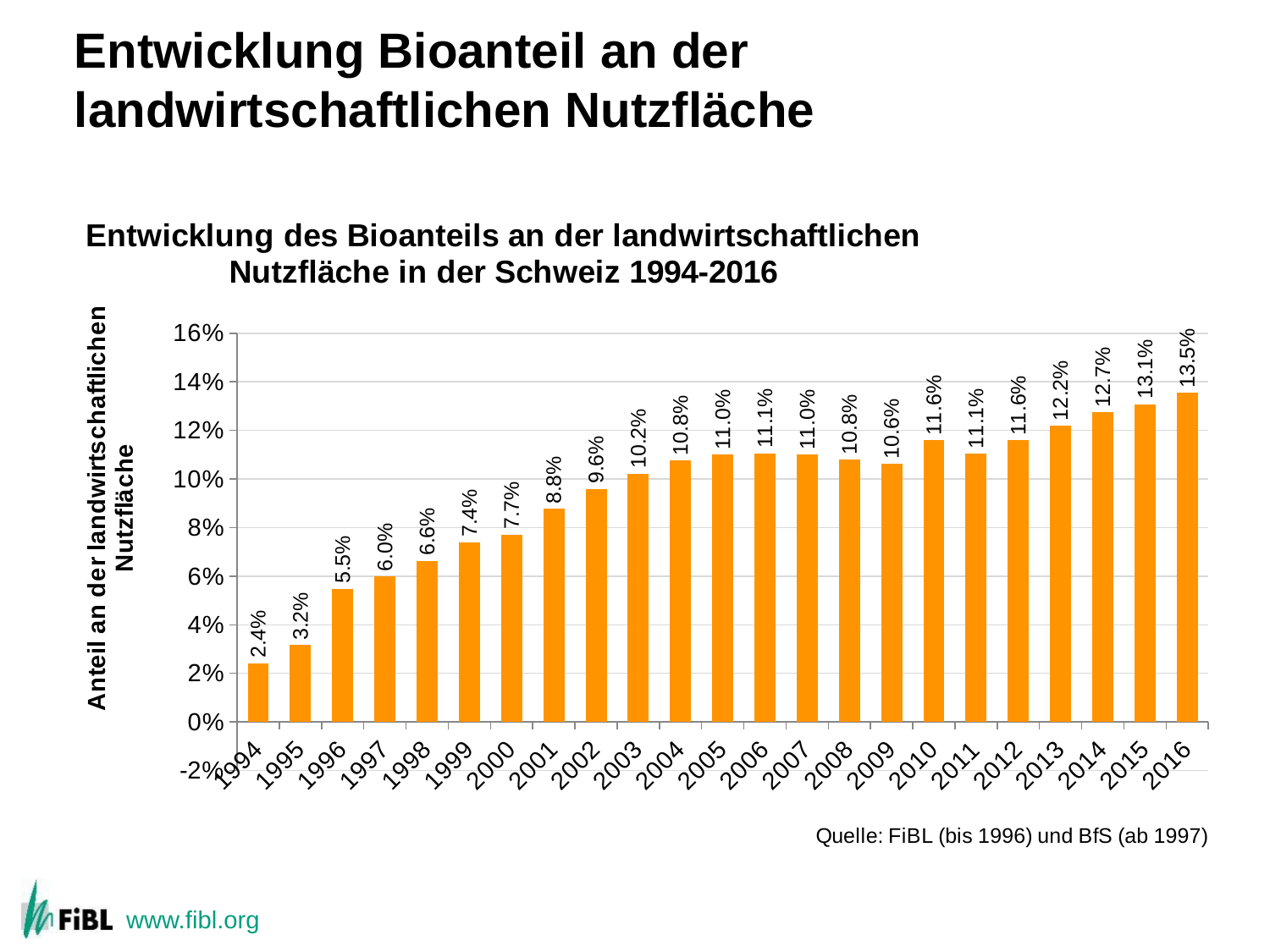
Which is larger, the value for 2008 or the value for 2009? 2008 How many years are shown on the x axis? 23 What is the value for 2003? 10.2% What is the value for 1994? 2.4% What is the y-axis label of the chart? Anteil an der landwirtschaftlichen Nutzfläche What is the difference between the values for 2016 and 1994? 11.1% Which year has the highest value? 2016 Is the value for 2001 greater or less than 8%? greater Which year has the lowest value? 1994 What is the value for 2016? 13.5% Do the values generally rise or fall from 1994 to 2016? Rise What kind of chart is this? Bar chart